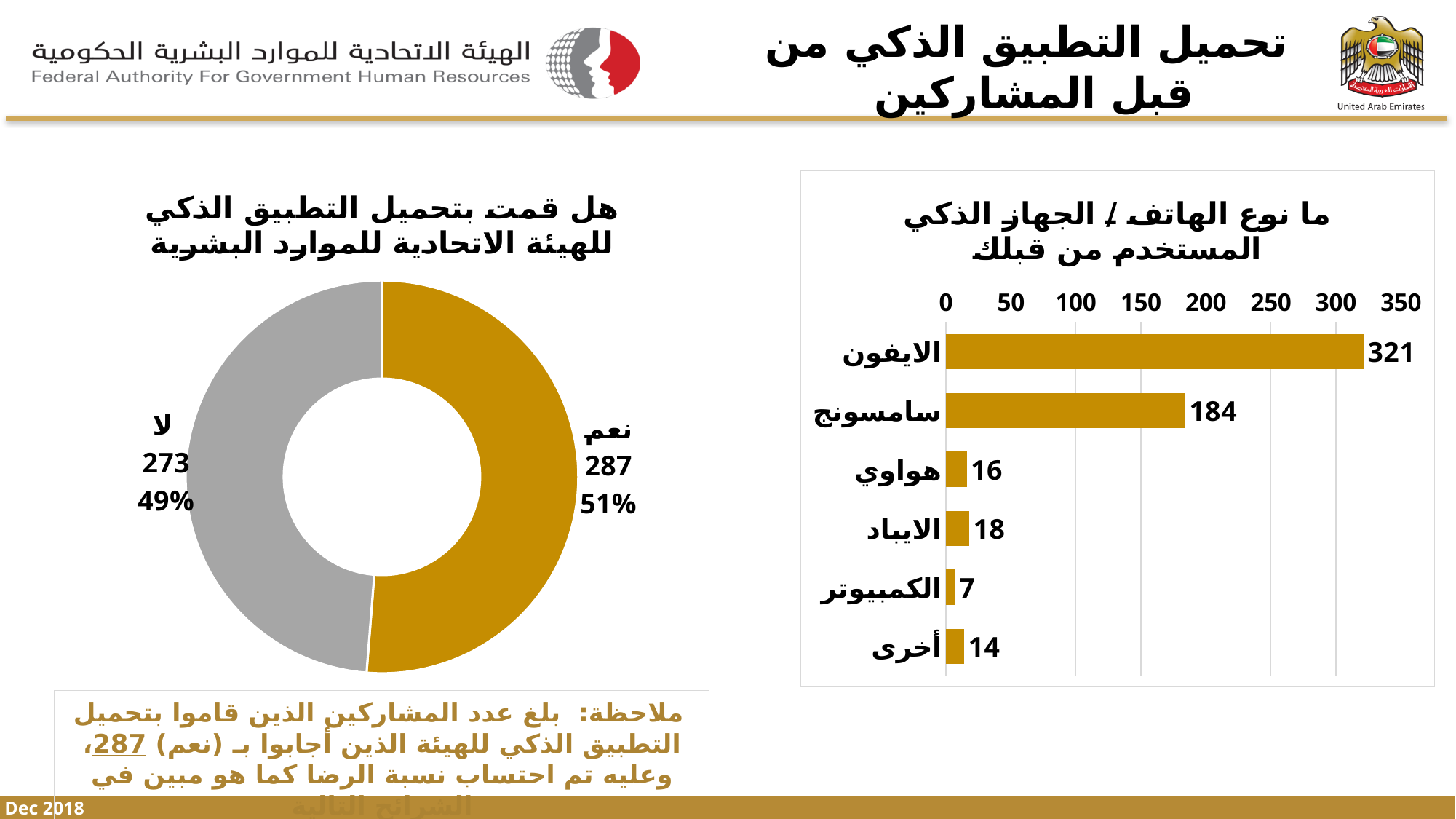
In the doughnut chart on the left, what percentage share does لا have? 49% In the doughnut chart on the left, what colour is the نعم slice? Gold What kind of chart is the chart on the right of the slide? Bar chart In the doughnut chart on the left (هل قمت بتحميل التطبيق الذكي للهيئة الاتحادية للموارد البشرية), what is the value for نعم? 287 In the bar chart on the right, what is the value for سامسونج? 184 In the bar chart on the right, which category has the lowest value? الكمبيوتر In the bar chart on the right, how many categories are shown? 6 In the bar chart on the right (ما نوع الهاتف / الجهاز الذكي المستخدم من قبلك), what is the value for الايفون? 321 In the doughnut chart on the left, what is the difference between the values for نعم and لا? 14 In the bar chart on the right, which category has the highest value? الايفون In the bar chart on the right, which is larger, the value for هواوي or the value for الايباد? الايباد In the bar chart on the right, what is the difference between the values for الايفون and سامسونج? 137